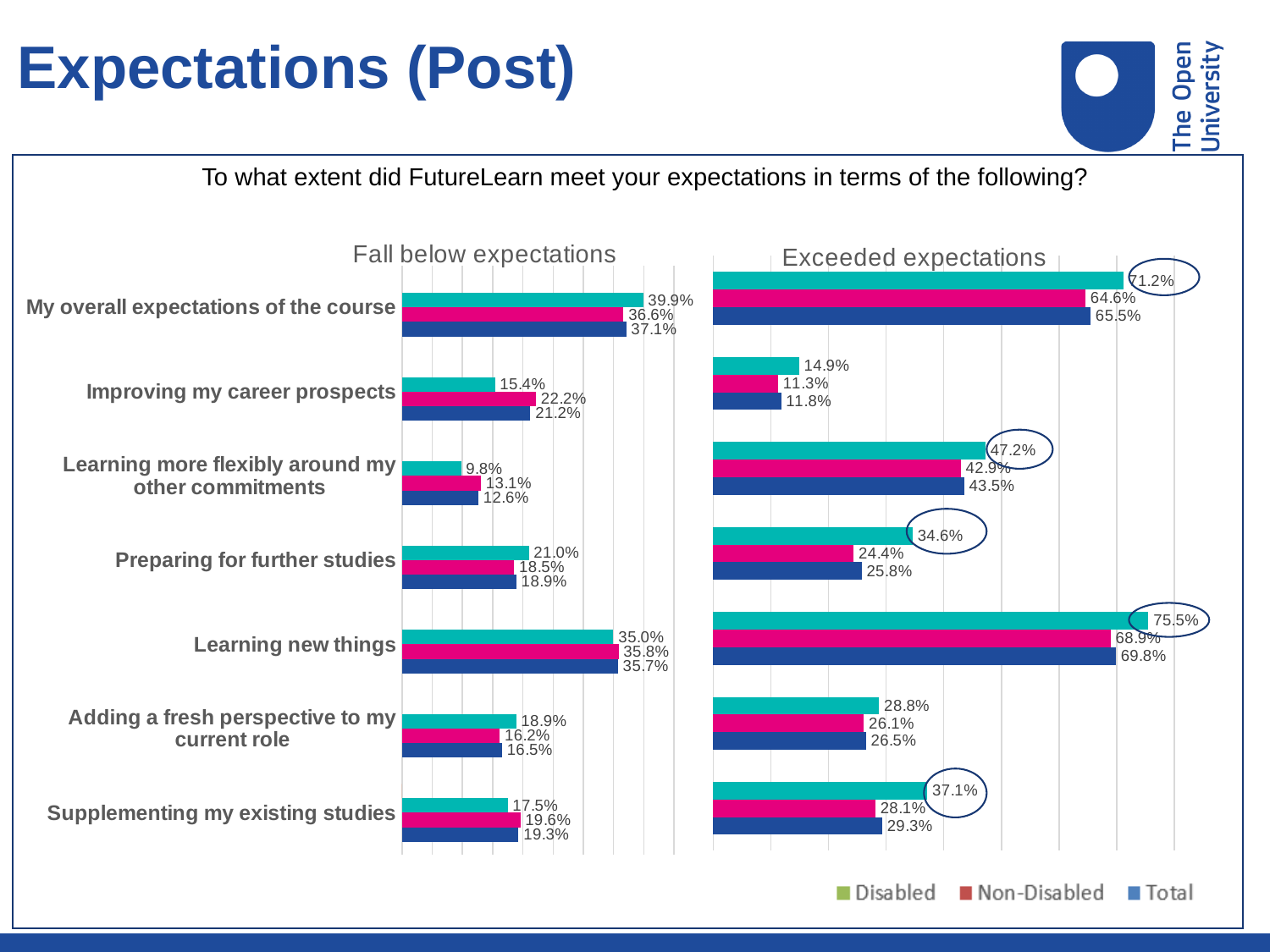
In the 'Exceeded expectations' chart, which category has the highest Disabled value? Learning new things What kind of chart is the 'Exceeded expectations' chart? Bar chart In the 'Fall below expectations' chart, which category has the lowest Disabled value? Learning more flexibly around my other commitments How many series does the legend list? 3 In the 'Fall below expectations' chart, which is larger for 'Improving my career prospects': the Disabled value or the Non-Disabled value? Non-Disabled In the 'Exceeded expectations' chart, what is the difference between the Disabled and Total values for 'My overall expectations of the course'? 5.7% In the 'Exceeded expectations' chart, what is the Non-Disabled value for 'Supplementing my existing studies'? 28.1% In the 'Exceeded expectations' chart, what is the Disabled value for 'Learning new things'? 75.5% In the 'Fall below expectations' chart, what is the Total value for 'Improving my career prospects'? 21.2% In the 'Exceeded expectations' chart, which is larger for 'Preparing for further studies': the Disabled value or the Total value? Disabled What question is shown above the charts? To what extent did FutureLearn meet your expectations in terms of the following? How many categories are shown in the 'Fall below expectations' chart? 7